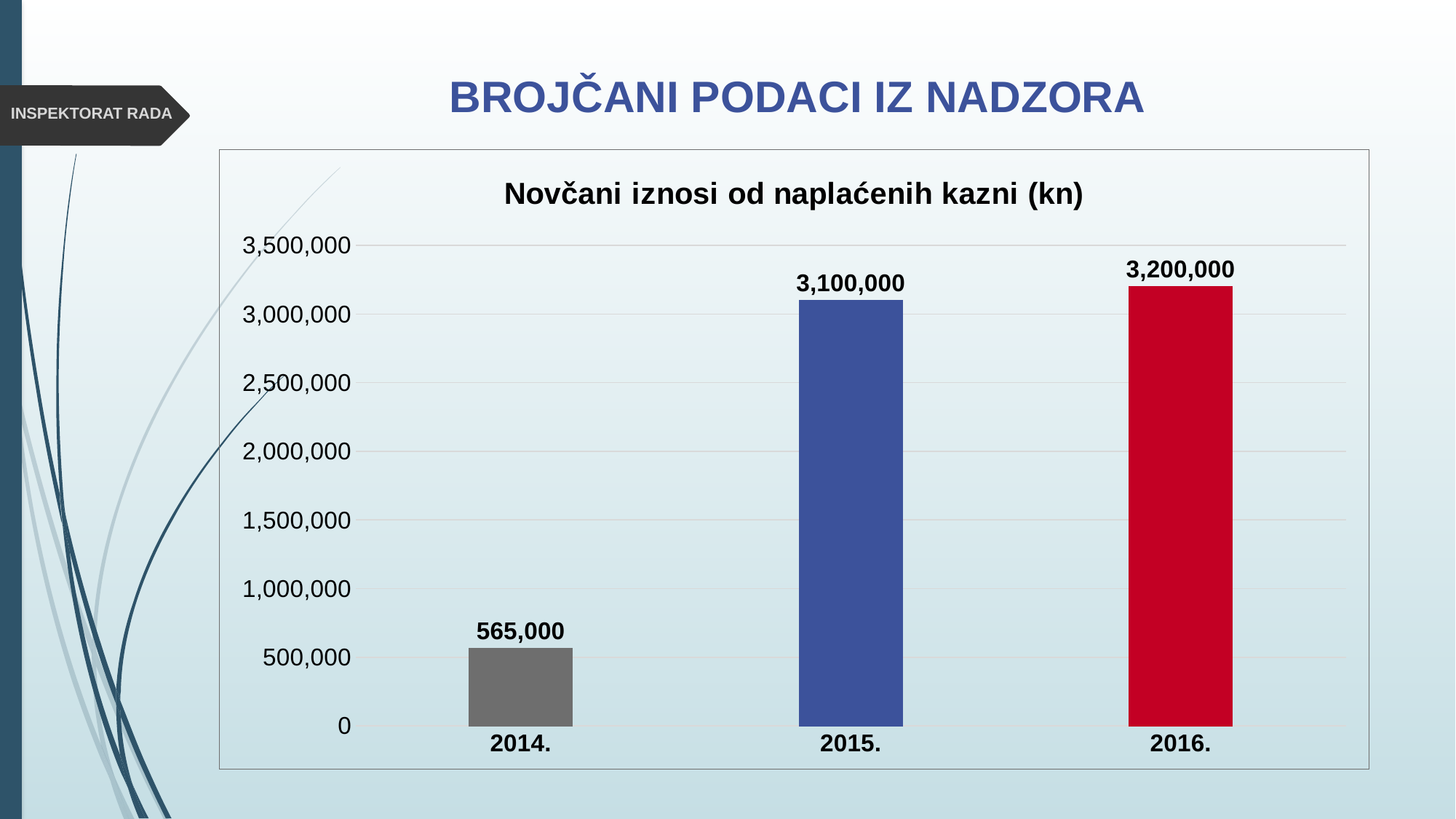
What is the value for 2014.? 565,000 Which year has the lowest value? 2014. What is the difference between the values for 2016. and 2015.? 100,000 What is the title of the chart? Novčani iznosi od naplaćenih kazni (kn) How many years are shown on the chart? 3 What is the value for 2015.? 3,100,000 What is the value for 2016.? 3,200,000 Which is larger, the value for 2014. or the value for 2015.? 2015. What kind of chart is shown? bar chart What is the difference between the values for 2015. and 2014.? 2,535,000 Which year has the highest value? 2016. Is the value for 2014. greater or less than 1,000,000? less